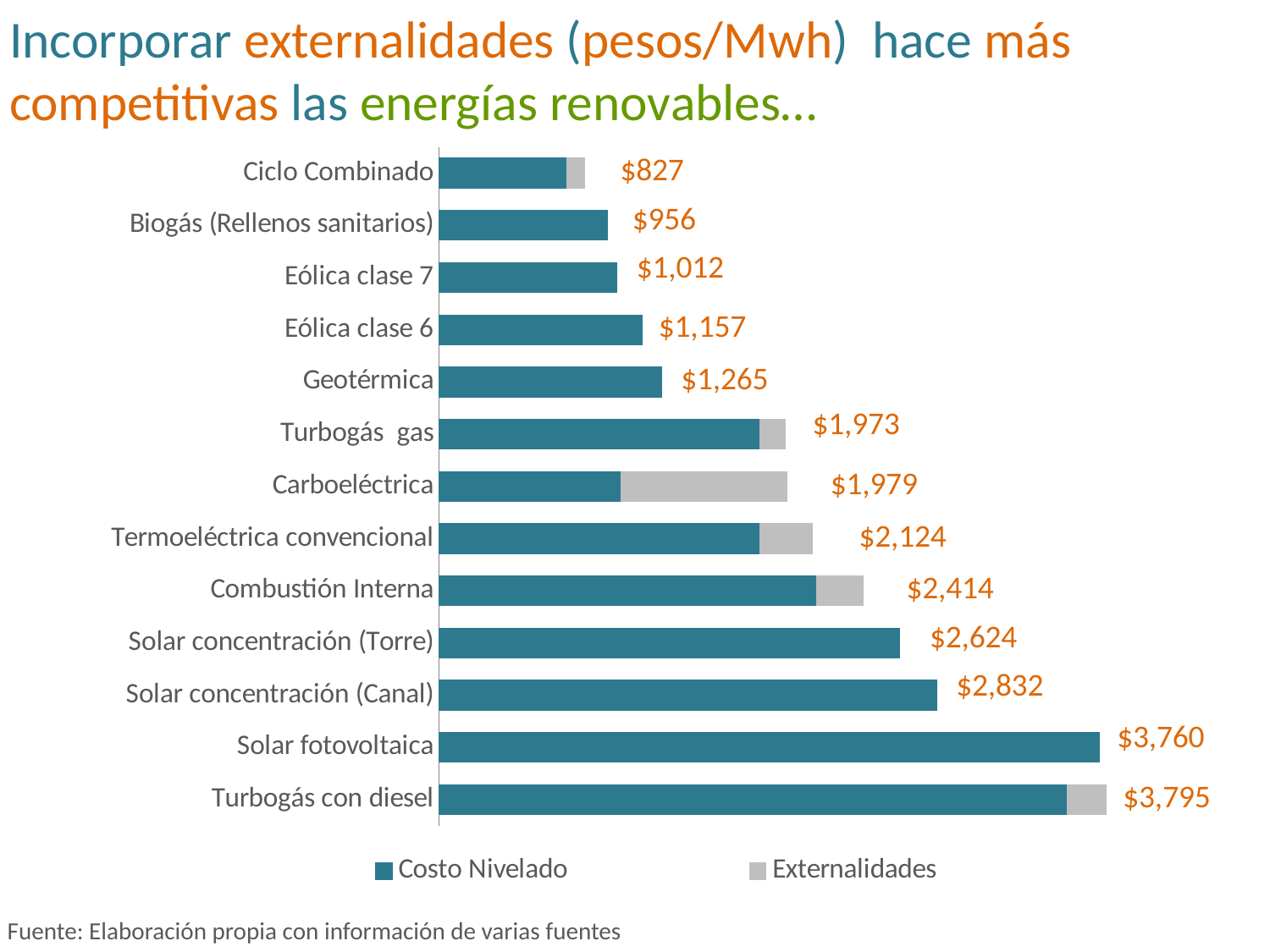
How many categories are shown in the chart? 13 What kind of chart is shown on the slide? Stacked bar chart What is the difference between the total for Solar concentración (Canal) and the total for Solar concentración (Torre)? $208 Which category has the highest total value? Turbogás con diesel What is the difference between the total for Eólica clase 6 and the total for Eólica clase 7? $145 Which series is shown in grey according to the legend? Externalidades What is the total value shown for Geotérmica? $1,265 What is the total value shown for Ciclo Combinado? $827 Which category has the lowest total value? Ciclo Combinado What is the total value shown for Solar fotovoltaica? $3,760 Which has a larger total value, Combustión Interna or Termoeléctrica convencional? Combustión Interna How many series does the legend list? 2